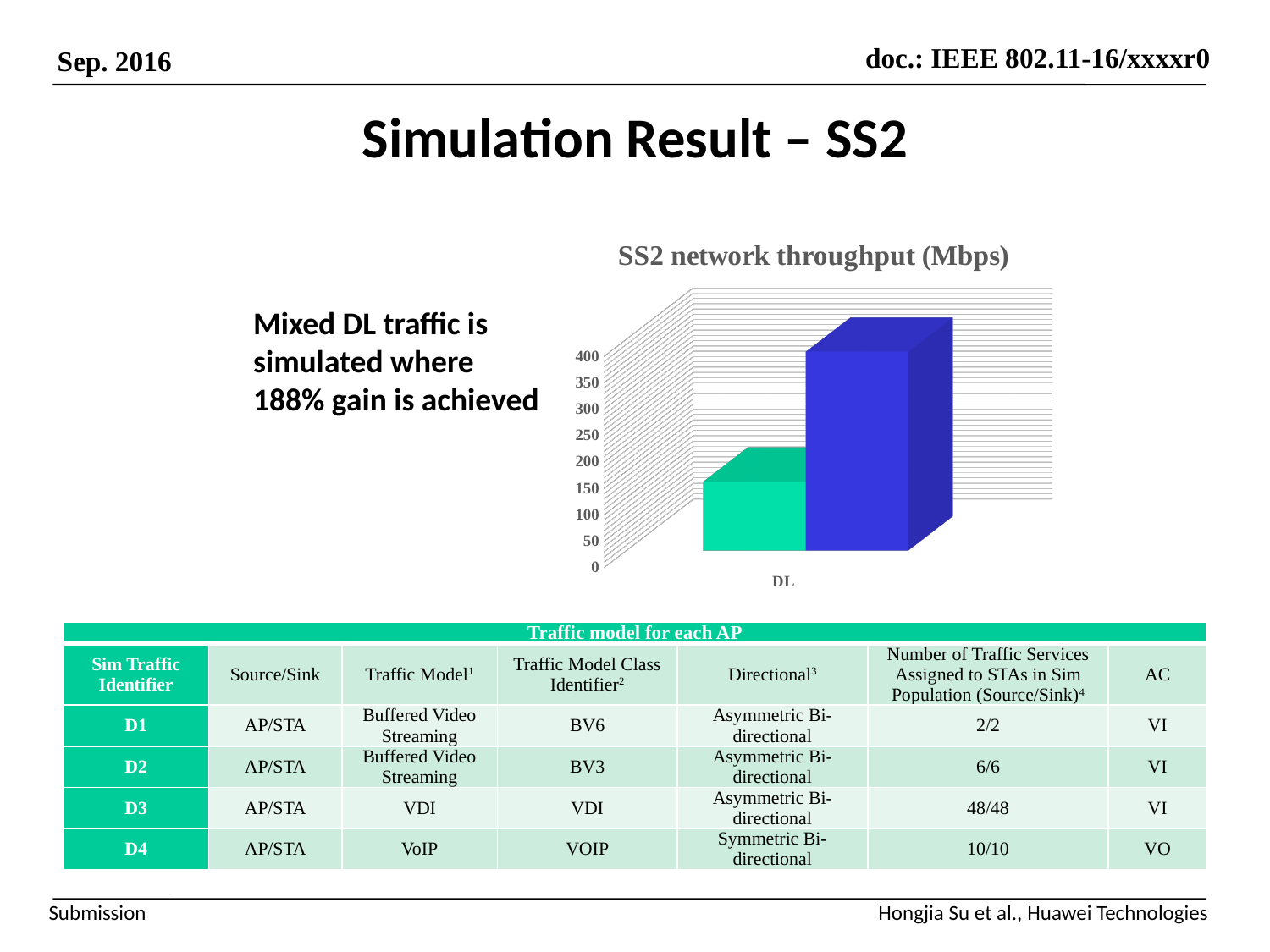
What is the highest tick value shown on the vertical axis of the chart? 400 What is the title of the chart? SS2 network throughput (Mbps) Is the value of the blue bar in the chart greater or less than 300? greater How many categories are shown on the x axis of the chart? 1 What is the label of the category on the x axis of the chart? DL Is the value of the green bar in the chart greater or less than 200? less Is the value of the blue bar in the chart greater or less than 350? greater Which bar is taller in the chart, the green bar or the blue bar? the blue bar What kind of chart is shown on the slide? bar chart